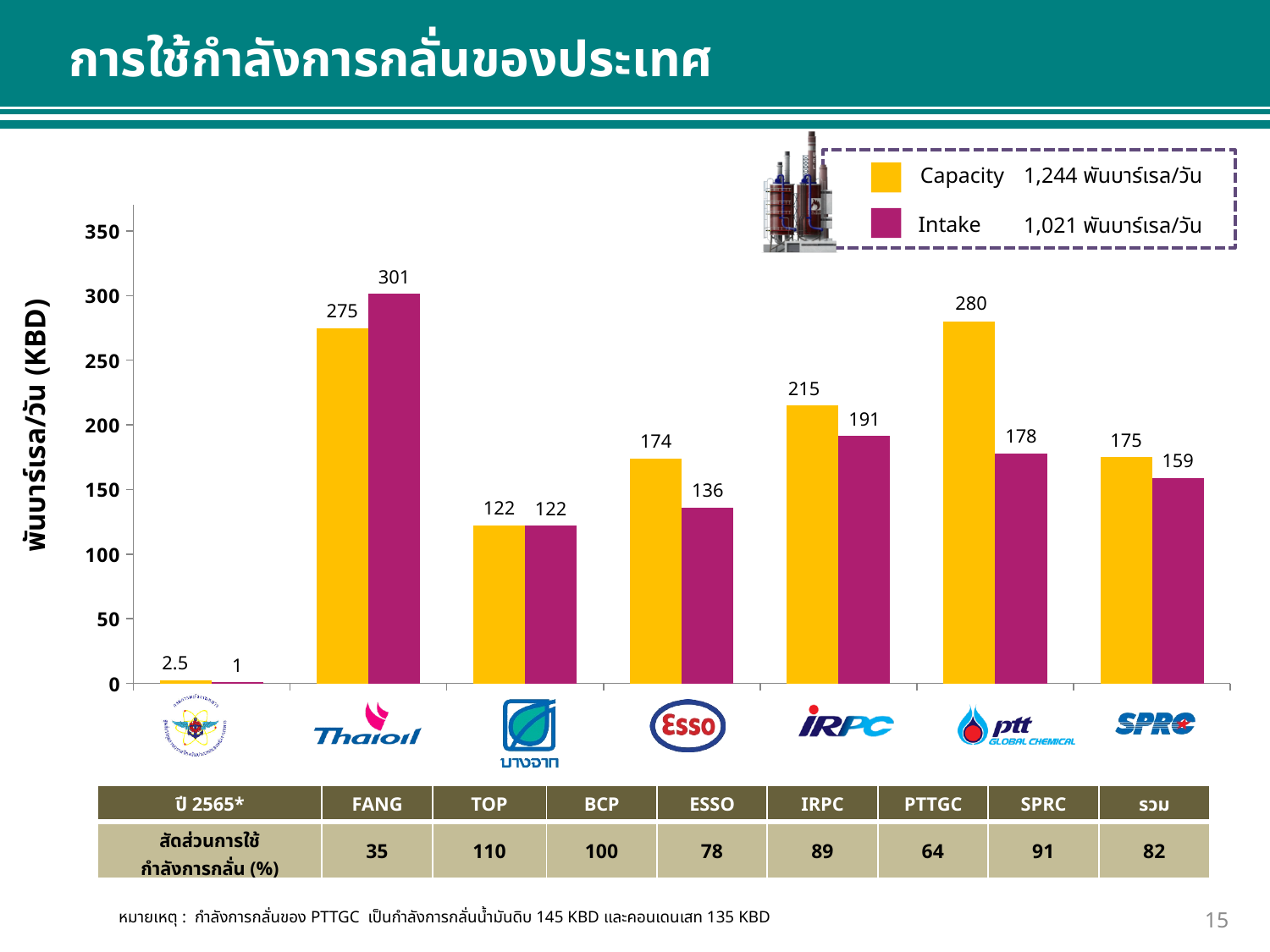
Which refinery has the lowest Intake bar? FANG What is the Intake value for Thaioil (TOP)? 301 What is the Intake value for ESSO? 136 What is the y-axis label of the chart? พันบาร์เรล/วัน (KBD) What kind of chart is shown on the slide? Bar chart What is the difference between Capacity and Intake for PTTGC? 102 How many refineries (categories) are shown on the x axis of the chart? 7 How many series does the legend list? 2 Which refinery has the highest Capacity bar? PTTGC What is the Capacity value for IRPC? 215 What total Capacity value is shown in the legend box? 1,244 พันบาร์เรล/วัน Which is larger for SPRC, Capacity or Intake? Capacity